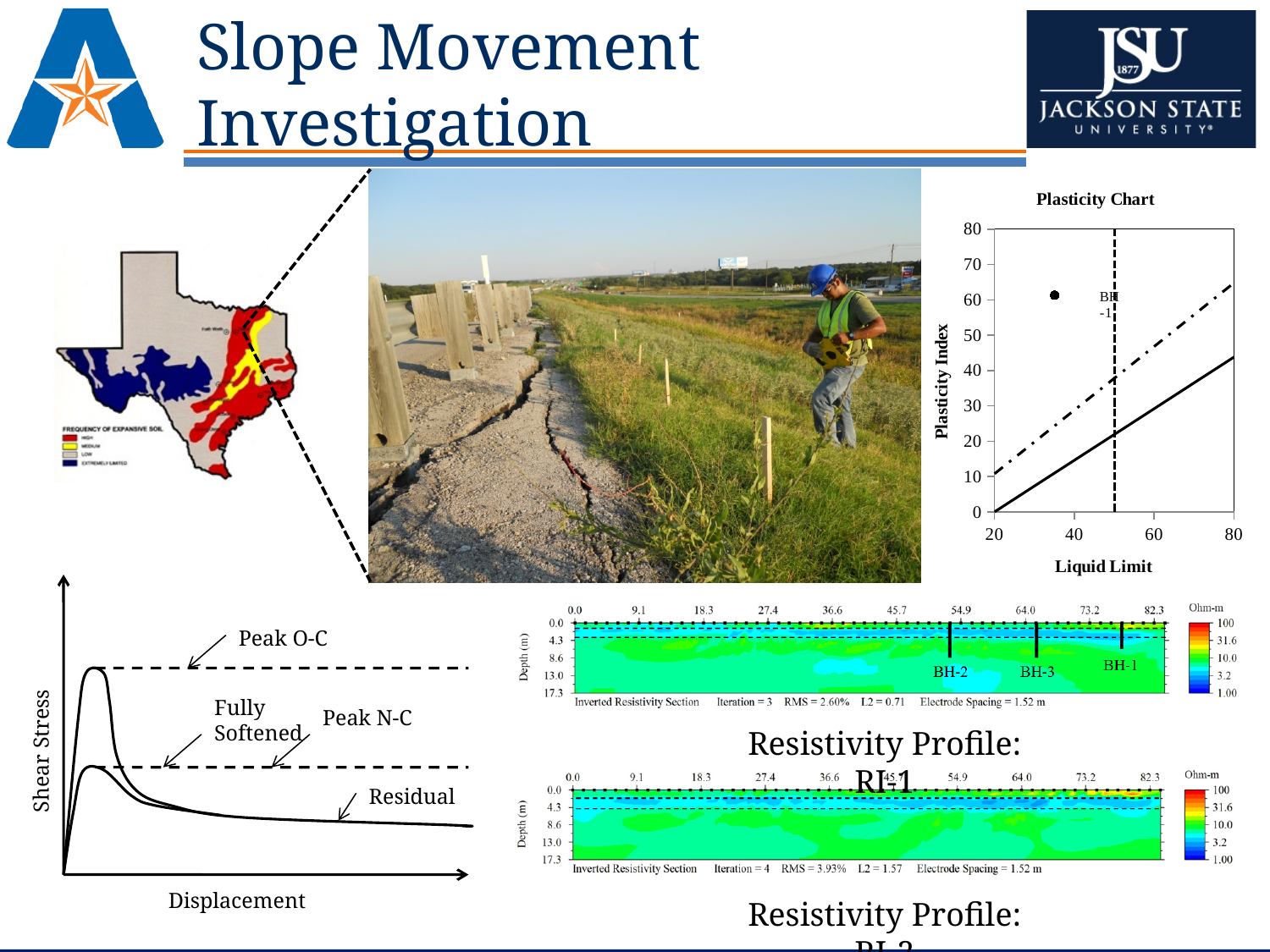
What is the title of the scatter chart on the right side of the slide? Plasticity Chart In the Plasticity Chart, what is the highest value shown on the Plasticity Index axis? 80 In the Plasticity Chart, what is the label of the x axis? Liquid Limit What kind of chart is the Shear Stress versus Displacement diagram at the bottom left? line chart In the Plasticity Chart, at what Liquid Limit value is the vertical dashed line drawn? 50 In the Plasticity Chart, is the Plasticity Index of the plotted point BH-1 greater or less than 50? greater In the Plasticity Chart, is the Liquid Limit of the plotted point BH-1 greater or less than 40? less In the Plasticity Chart, how many data points are plotted? 1 In the Shear Stress versus Displacement chart, how many curves are plotted? 2 In the Shear Stress versus Displacement chart, does shear stress rise or fall with displacement after the peak? fall In the Shear Stress versus Displacement chart, which labelled level is higher: Peak O-C or Peak N-C? Peak O-C In the Resistivity Profile RI-1 (top inverted resistivity section), what is the RMS value printed below the section? 2.60%